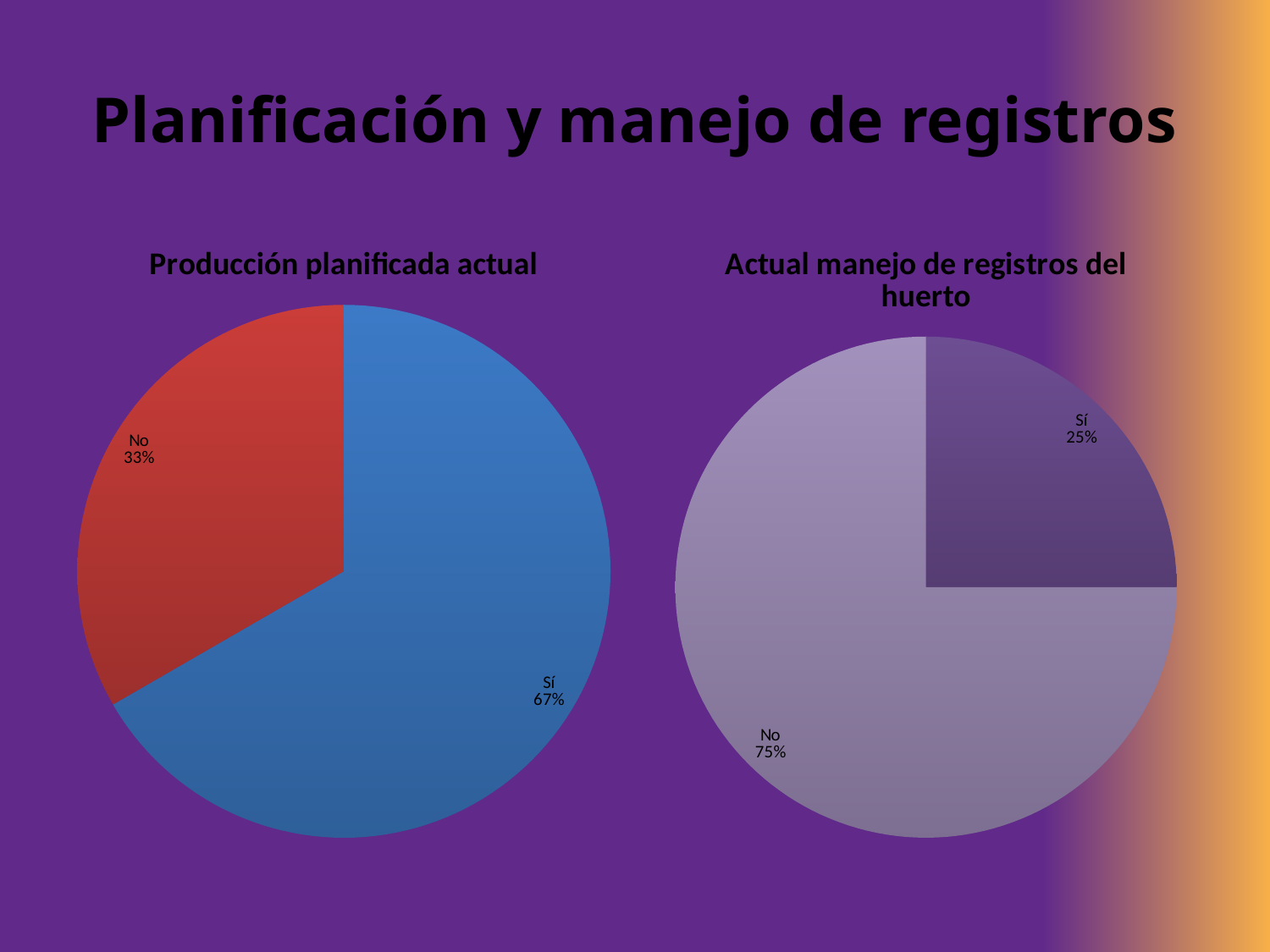
In the 'Actual manejo de registros del huerto' chart, which is larger, 'Sí' or 'No'? No In the 'Producción planificada actual' chart, which slice is the largest? Sí In the 'Actual manejo de registros del huerto' chart, what percentage is shown for 'Sí'? 25% How many slices does the 'Actual manejo de registros del huerto' chart have? 2 In the 'Producción planificada actual' chart, what is the difference between the 'Sí' and 'No' percentages? 34% In the 'Actual manejo de registros del huerto' chart, what is the difference between the 'No' and 'Sí' percentages? 50% What kind of chart is the 'Producción planificada actual' chart? Pie chart In the 'Producción planificada actual' chart, what percentage is shown for 'No'? 33% In the 'Producción planificada actual' chart, what percentage is shown for 'Sí'? 67% What is the title of the chart on the left side of the slide? Producción planificada actual In the 'Actual manejo de registros del huerto' chart, which slice is the smallest? Sí In the 'Actual manejo de registros del huerto' chart, what percentage is shown for 'No'? 75%